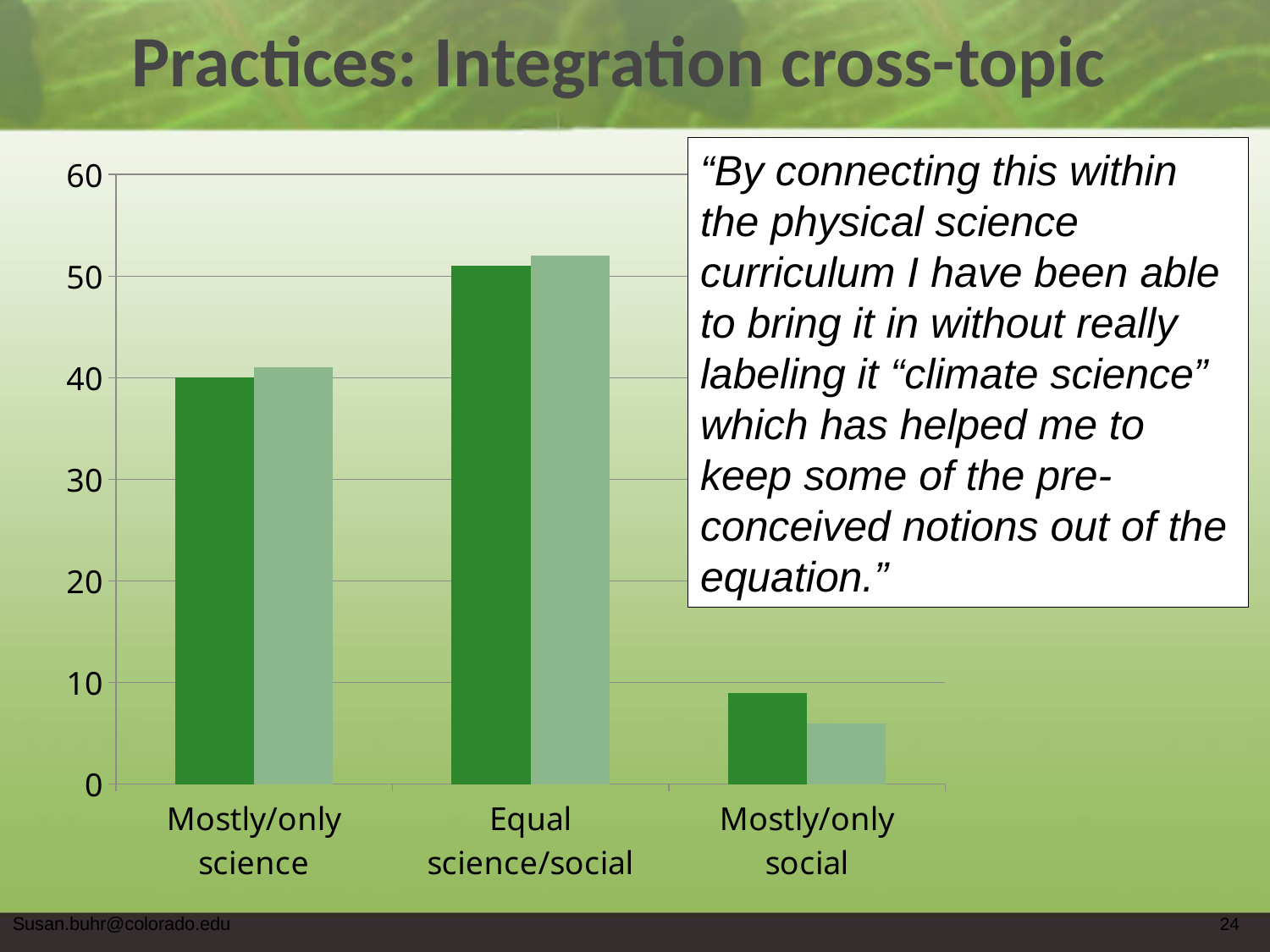
Which category has the shortest bars in the chart? Mostly/only social How many categories are shown on the x axis of the chart? 3 What is the highest value shown on the chart's vertical axis? 60 Is the light green bar for Equal science/social greater or less than 50? greater What kind of chart is shown on the slide? bar chart Is the dark green bar for Equal science/social greater or less than 50? greater Is the dark green bar for Mostly/only science greater or less than 30? greater Which has the taller dark green bar: Mostly/only science or Mostly/only social? Mostly/only science What is the title of the slide containing the chart? Practices: Integration cross-topic For the Mostly/only social category, which bar is taller: the dark green or the light green one? dark green Which category has the tallest bars in the chart? Equal science/social